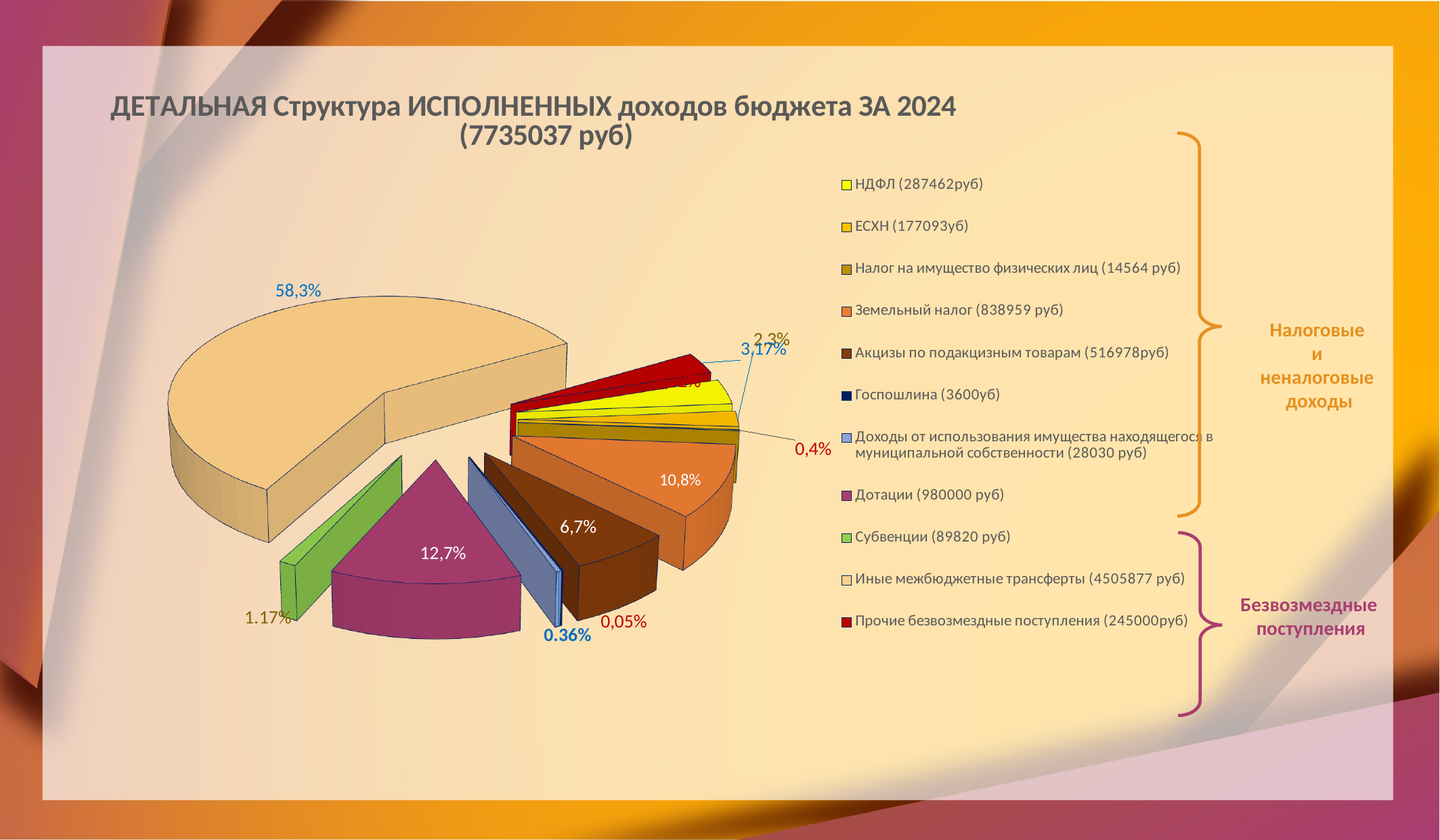
What share of the pie does Субвенции account for? 1.17% How many categories does the legend of the pie chart list? 11 What total amount in rubles is given in the chart title? 7735037 руб By how many percentage points does the share of Иные межбюджетные трансферты exceed the share of Дотации? 45,6 What share of the pie does Акцизы по подакцизным товарам account for? 6,7% What kind of chart is shown on the slide? pie chart Which category has the smallest slice of the pie chart? Госпошлина What share of the pie does Иные межбюджетные трансферты account for? 58,3% Which slice is larger: Дотации or Земельный налог? Дотации Which category has the largest slice of the pie chart? Иные межбюджетные трансферты